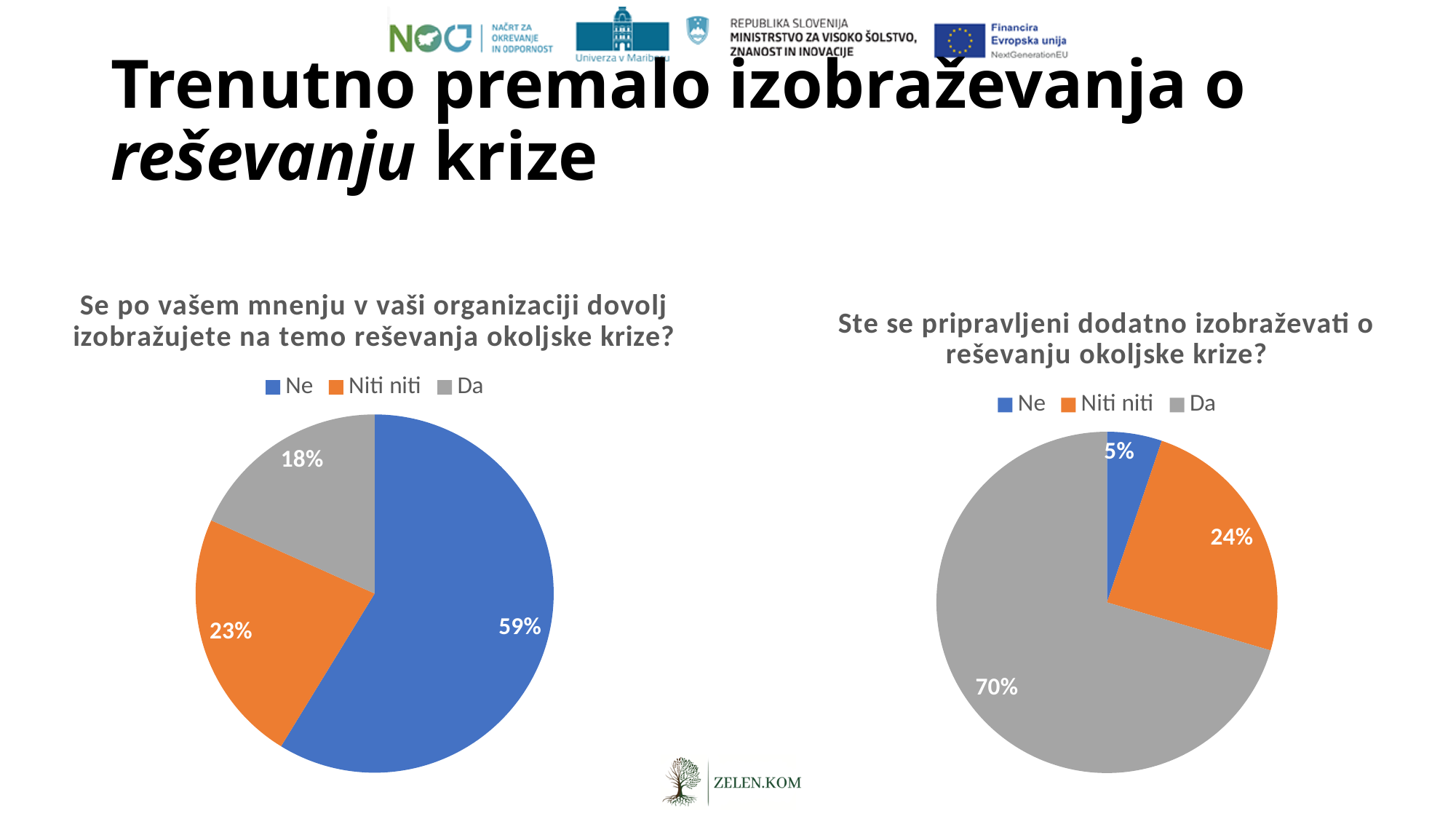
In the left pie chart, which answer has the largest share? Ne In the right pie chart, what percentage is shown for "Niti niti"? 24% In the left pie chart, what percentage is shown for "Da"? 18% In the left pie chart ("Se po vašem mnenju v vaši organizaciji dovolj izobražujete na temo reševanja okoljske krize?"), what share of respondents answered "Ne"? 59% In the left pie chart, what is the difference in percentage points between "Ne" and "Da"? 41 In the right pie chart, which is larger: the share for "Da" or the share for "Niti niti"? Da In the right pie chart ("Ste se pripravljeni dodatno izobraževati o reševanju okoljske krize?"), what share of respondents answered "Da"? 70% In the left pie chart, which colour represents "Niti niti"? Orange In the left pie chart, what percentage is shown for "Niti niti"? 23% In the right pie chart, which answer has the smallest share? Ne How many categories does the legend of the right pie chart list? 3 What type of chart is used on the left side of the slide? Pie chart